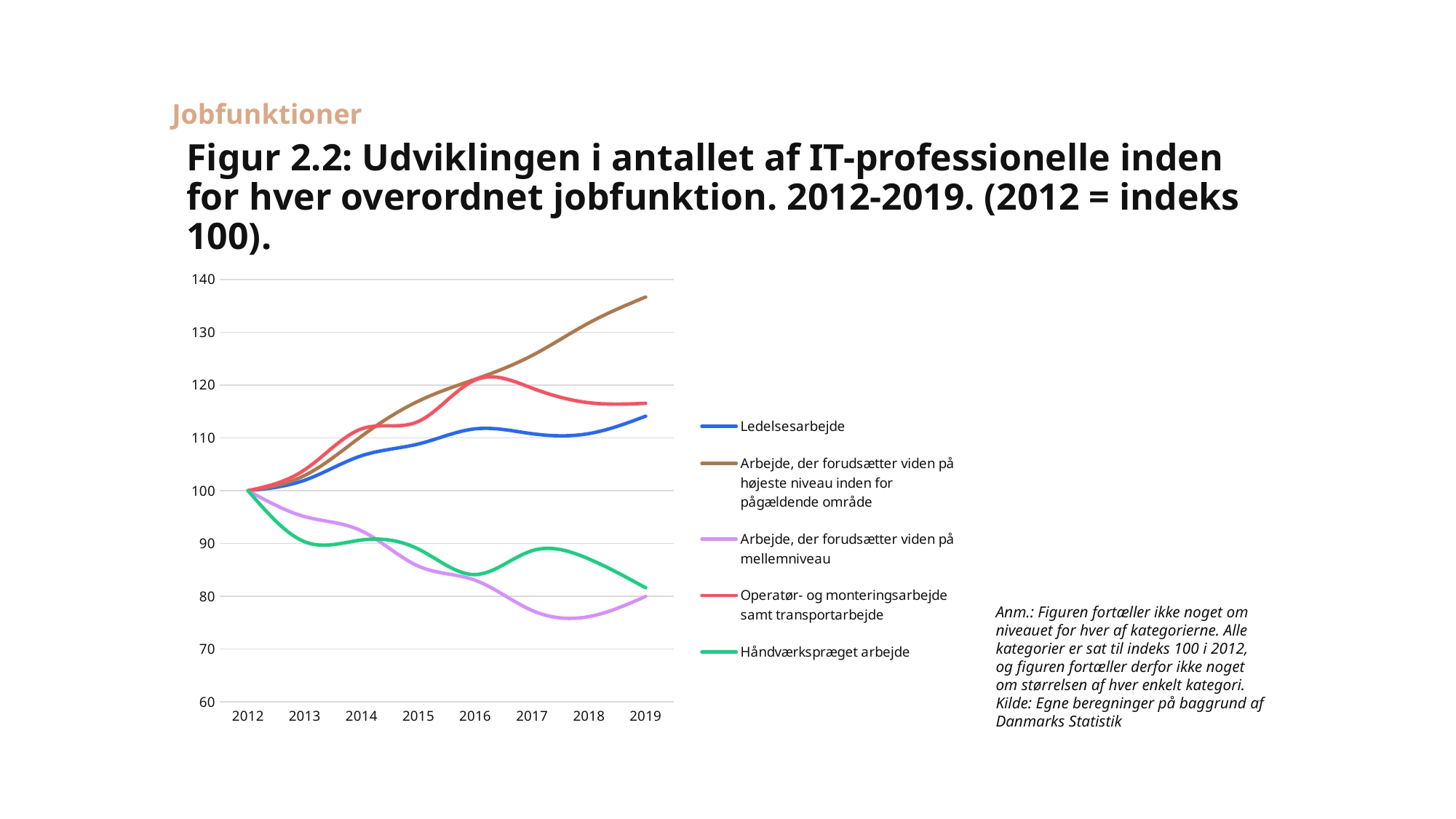
Is the 2019 value for Arbejde, der forudsætter viden på højeste niveau inden for pågældende område greater or less than 130? greater Which series has the lowest value in 2018? Arbejde, der forudsætter viden på mellemniveau What colour is the line for Håndværkspræget arbejde? Green Is the 2018 value for Arbejde, der forudsætter viden på mellemniveau greater or less than 80? less How many series does the legend list? 5 What is the index value for Ledelsesarbejde in 2012? 100 Is the 2019 value for Operatør- og monteringsarbejde samt transportarbejde greater or less than 120? less How many years are shown along the x axis? 8 In 2019, which is larger: Ledelsesarbejde or Arbejde, der forudsætter viden på højeste niveau inden for pågældende område? Arbejde, der forudsætter viden på højeste niveau inden for pågældende område Which series has the highest value in 2019? Arbejde, der forudsætter viden på højeste niveau inden for pågældende område Does the line for Arbejde, der forudsætter viden på højeste niveau inden for pågældende område rise or fall from 2012 to 2019? Rise What kind of chart is shown on the slide? Line chart